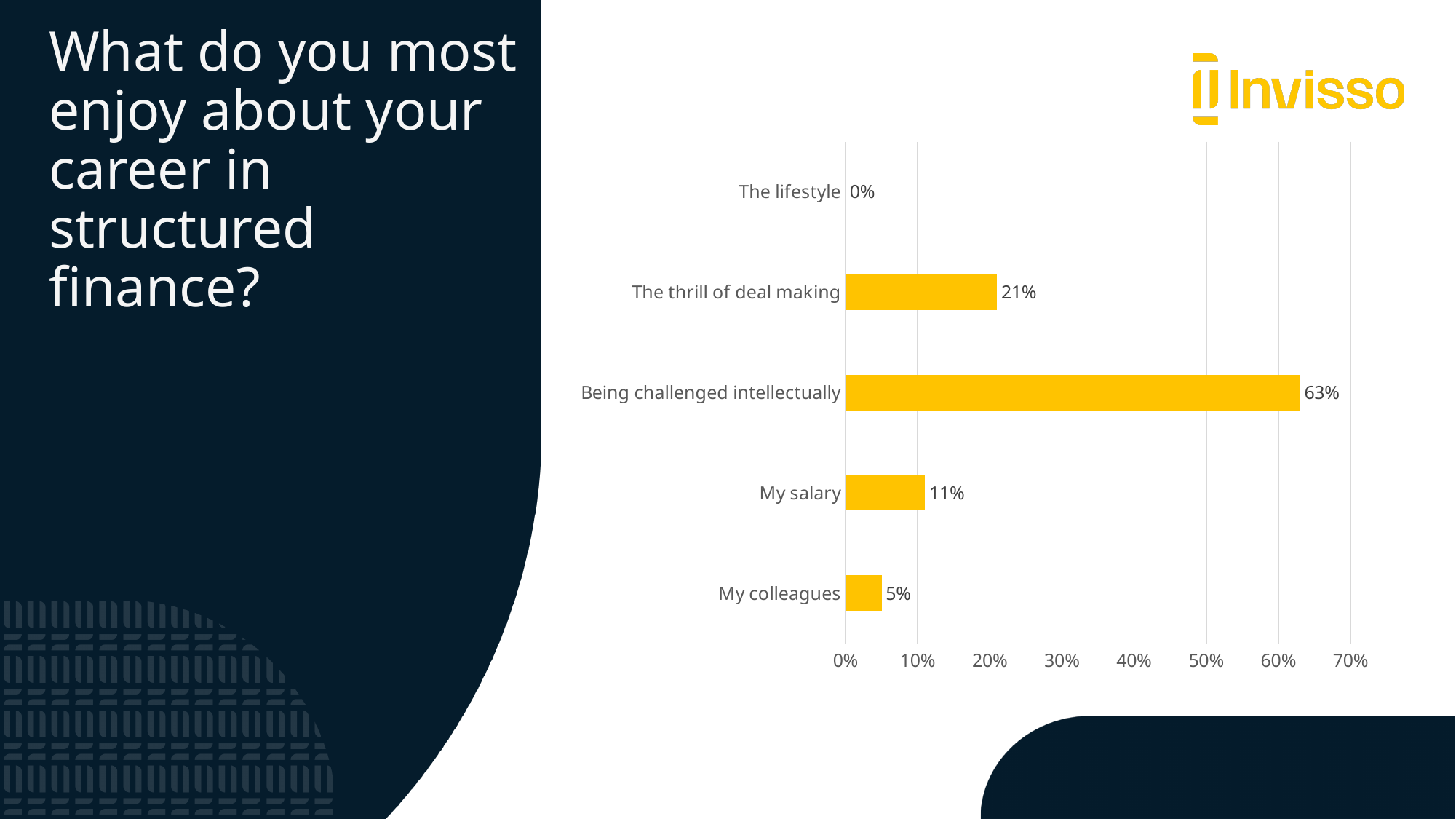
What is the value for 'The thrill of deal making'? 21% Which category has the highest value? Being challenged intellectually What is the title of the slide? What do you most enjoy about your career in structured finance? What is the difference between 'Being challenged intellectually' and 'The thrill of deal making'? 42% What percentage of respondents chose 'Being challenged intellectually'? 63% What is the value for 'The lifestyle'? 0% Which category has the lowest value? The lifestyle What is the value for 'My colleagues'? 5% Which is larger, 'My salary' or 'My colleagues'? My salary What is the value for 'My salary'? 11% What kind of chart is shown on the slide? Bar chart How many categories are shown in the chart? 5